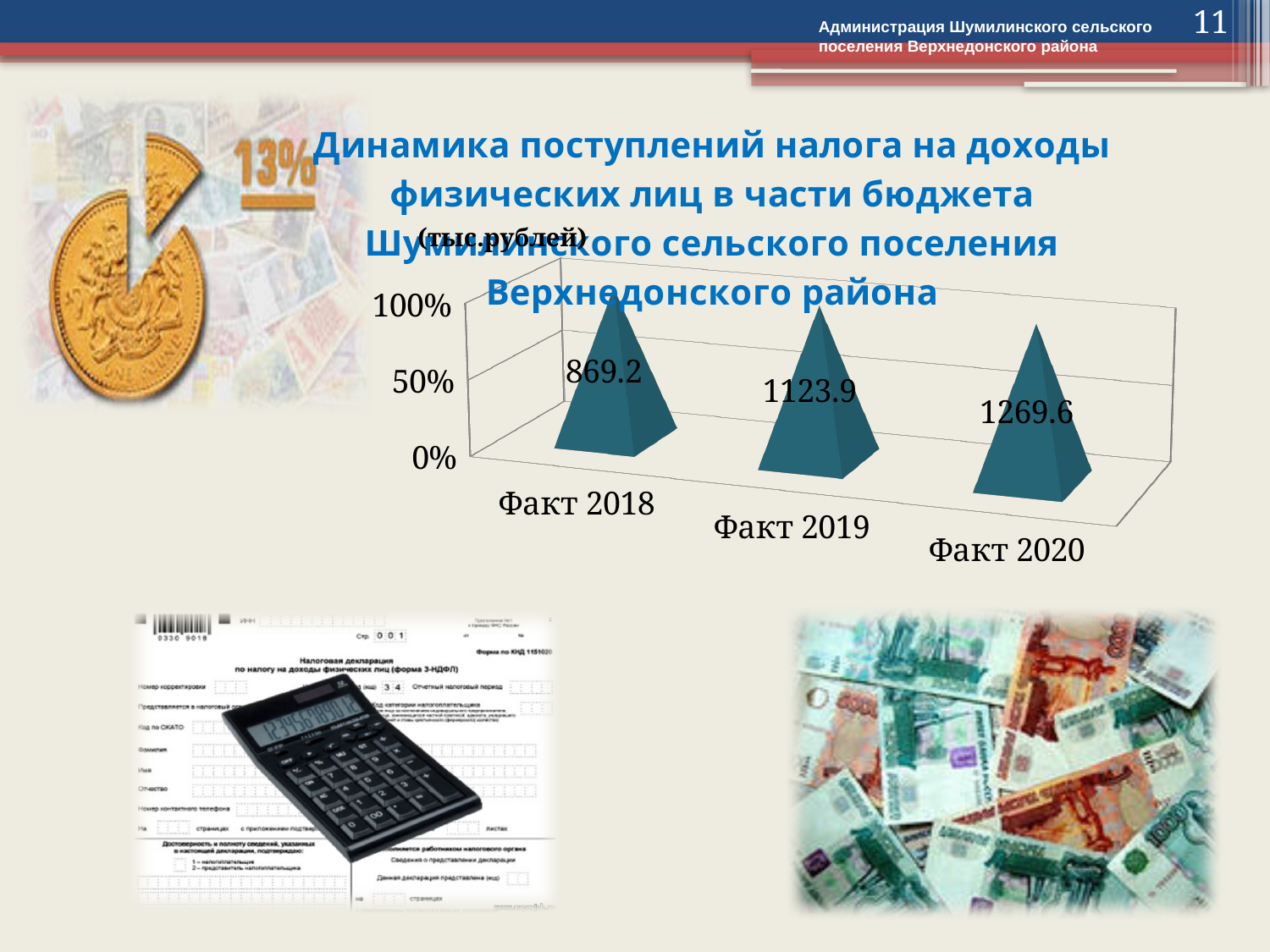
What is the value for Факт 2019? 1123.9 Do the values rise or fall from Факт 2018 to Факт 2020? Rise What kind of chart is shown on the slide? Bar chart Which category has the highest value? Факт 2020 What is the difference between the values for Факт 2019 and Факт 2018? 254.7 How many categories are shown on the chart? 3 Which category has the lowest value? Факт 2018 What is the value for Факт 2018? 869.2 In what units are the chart values given, according to the chart title? тыс.рублей What is the difference between the values for Факт 2020 and Факт 2019? 145.7 Which is larger, the value for Факт 2018 or the value for Факт 2019? Факт 2019 What is the value for Факт 2020? 1269.6